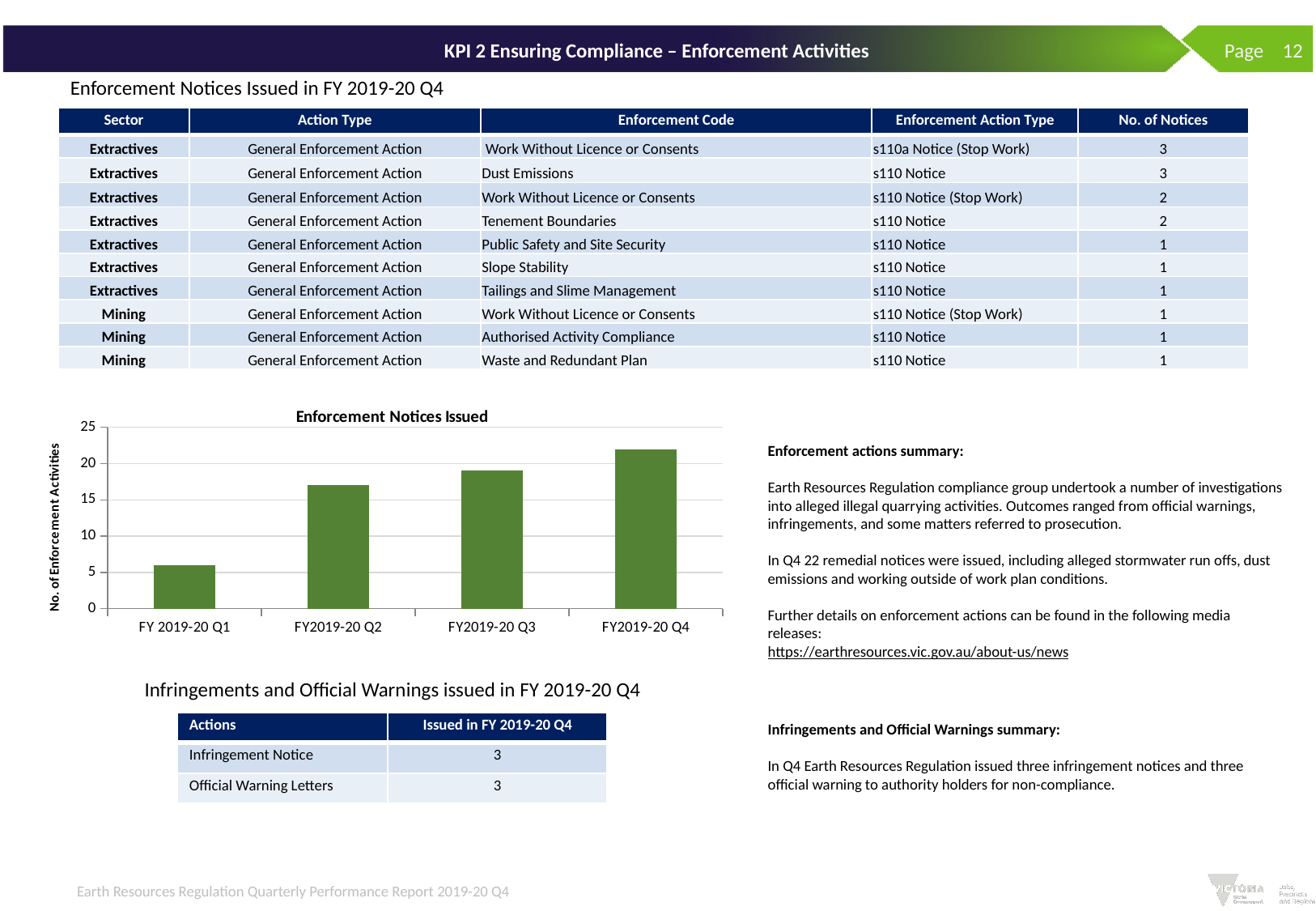
Which quarter has the highest number of enforcement notices issued on the chart? FY2019-20 Q4 Which quarter has the lowest number of enforcement notices issued on the chart? FY 2019-20 Q1 Is the value for FY2019-20 Q4 on the "Enforcement Notices Issued" chart greater or less than 20? greater Is the value for FY2019-20 Q2 on the "Enforcement Notices Issued" chart greater or less than 15? greater What is the title of the bar chart on the slide? Enforcement Notices Issued What is the label on the vertical axis of the "Enforcement Notices Issued" chart? No. of Enforcement Activities On the "Enforcement Notices Issued" chart, which is larger: the value for FY 2019-20 Q1 or FY2019-20 Q2? FY2019-20 Q2 How many quarters are plotted on the "Enforcement Notices Issued" chart? 4 Is the value for FY2019-20 Q3 on the "Enforcement Notices Issued" chart greater or less than 15? greater What kind of chart is the "Enforcement Notices Issued" chart? bar chart Do the values on the "Enforcement Notices Issued" chart rise or fall from FY 2019-20 Q1 to FY2019-20 Q4? rise